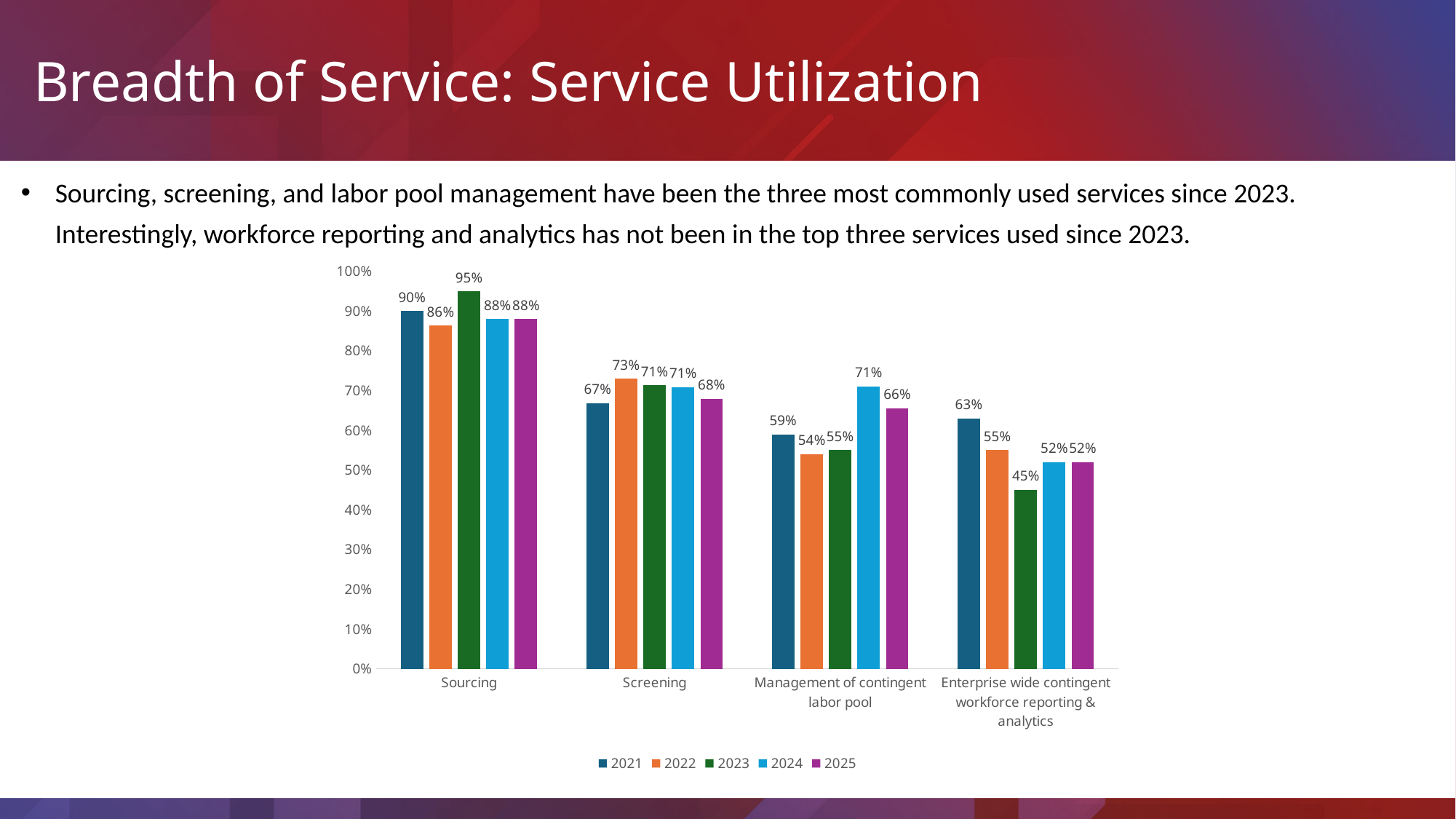
What is the difference between the 2023 and 2022 values for Sourcing? 9% What is the value for Management of contingent labor pool in 2024? 71% How many categories are shown on the x axis? 4 What is the value for Sourcing in 2023? 95% Which year does the orange series represent in the legend? 2022 Which is larger for Screening: the 2021 value or the 2025 value? 2025 Which category has the lowest value in 2025? Enterprise wide contingent workforce reporting & analytics Which category has the highest value in 2021? Sourcing How many series does the legend list? 5 What is the value for Enterprise wide contingent workforce reporting & analytics in 2023? 45% What is the value for Screening in 2022? 73% What kind of chart is shown on the slide? Bar chart